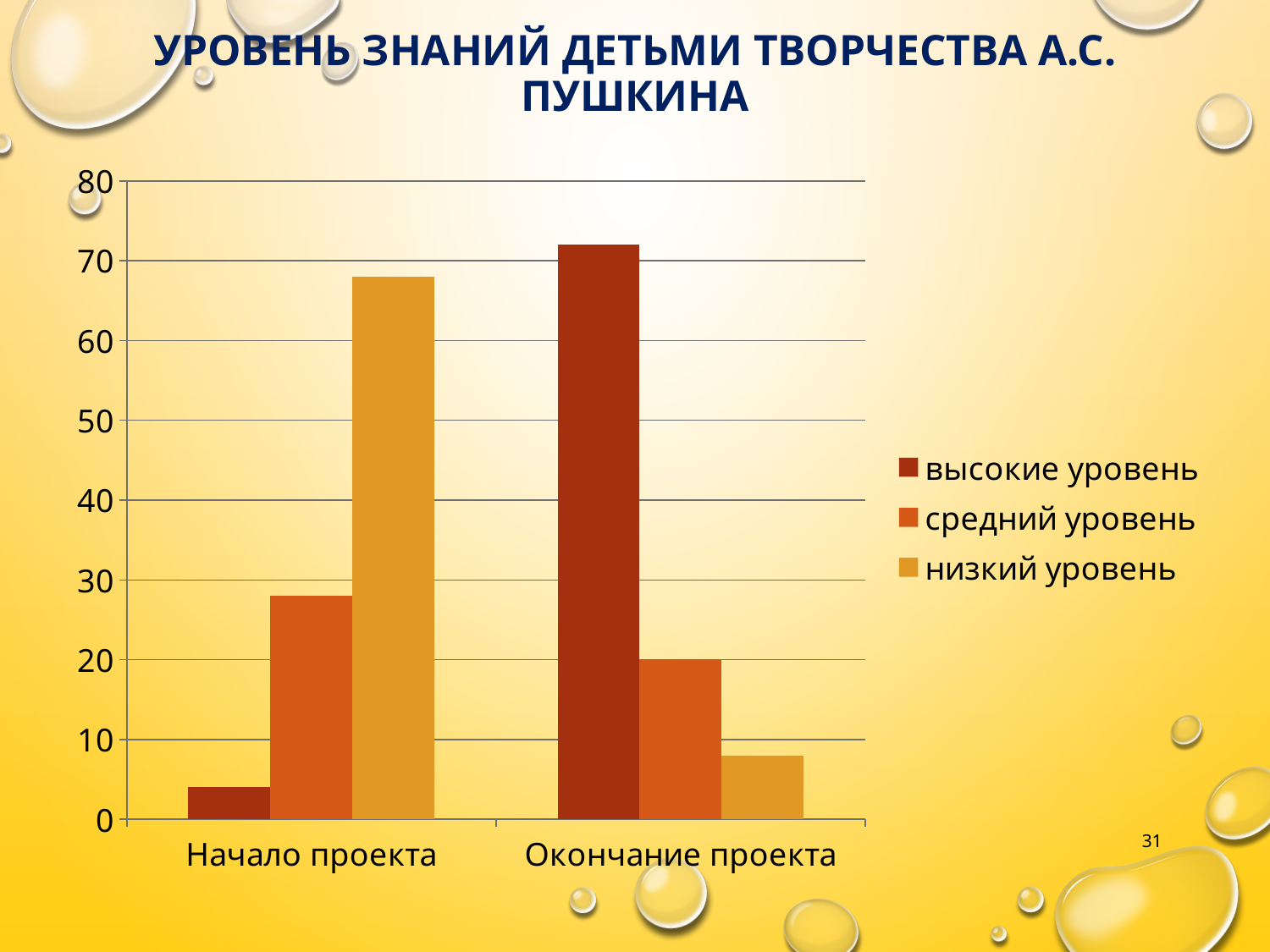
Which series has the highest value for Окончание проекта? высокие уровень Which series has the lowest value for Окончание проекта? низкий уровень Is the value for высокие уровень at Окончание проекта greater or less than 70? greater Which is larger: средний уровень at Начало проекта or средний уровень at Окончание проекта? Начало проекта Is the value for высокие уровень at Начало проекта greater or less than 10? less Which series has the lowest value for Начало проекта? высокие уровень What kind of chart is shown on the slide? bar chart How many categories are shown on the x axis? 2 Which series has the highest value for Начало проекта? низкий уровень Does the value for высокие уровень rise or fall from Начало проекта to Окончание проекта? rise How many series does the legend list? 3 Is the value for низкий уровень at Начало проекта greater or less than 60? greater